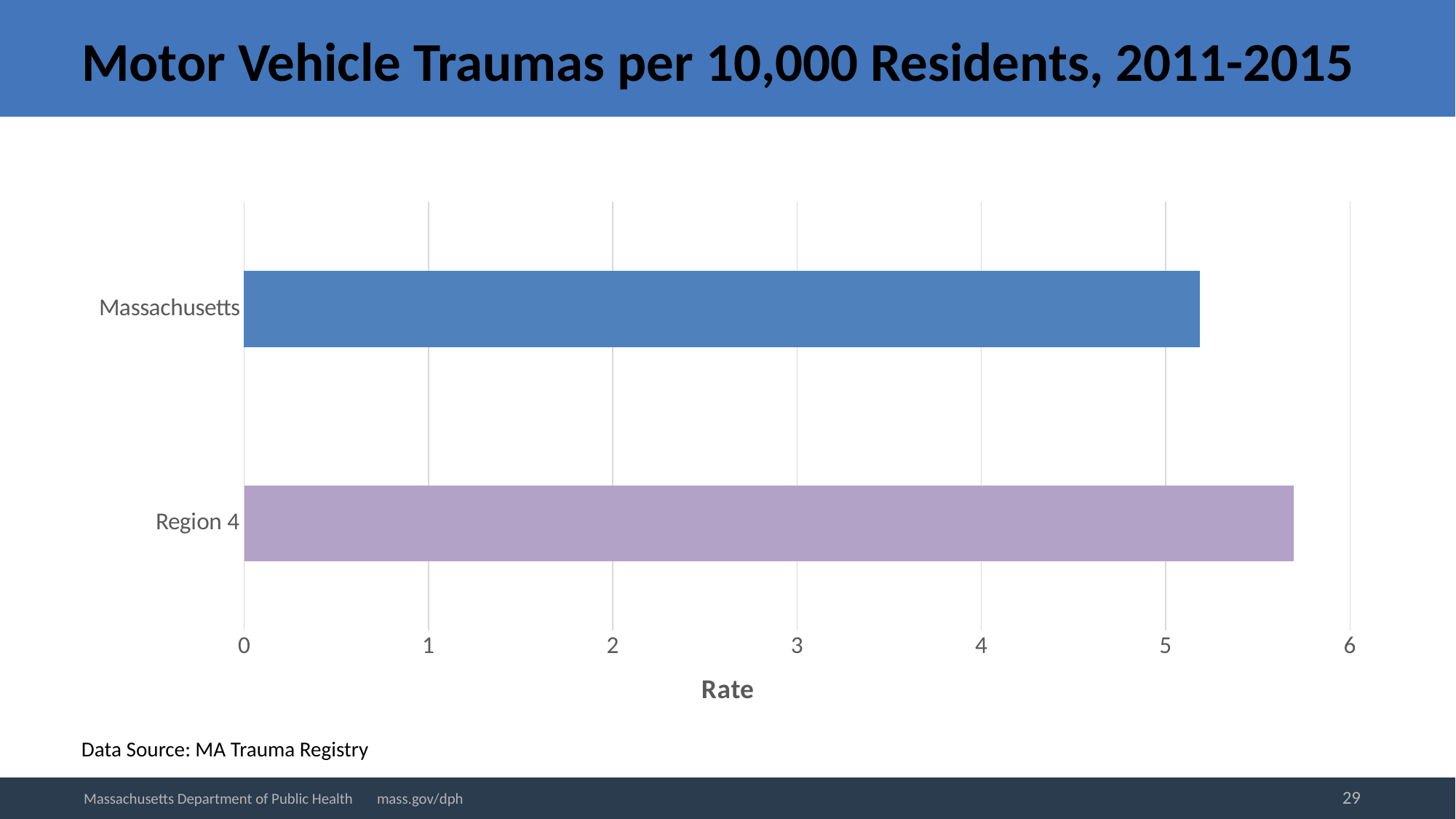
Is the value for Massachusetts greater or less than 5? greater What is the label on the horizontal axis of the chart? Rate Which is larger, the rate for Region 4 or the rate for Massachusetts? Region 4 Is the value for Massachusetts greater or less than 4? greater Is the value for Region 4 greater or less than 6? less What kind of chart is shown on the slide? bar chart What is the title of the chart on the slide? Motor Vehicle Traumas per 10,000 Residents, 2011-2015 How many categories are plotted in the chart? 2 Which category has the highest rate? Region 4 Which category has the lowest rate? Massachusetts